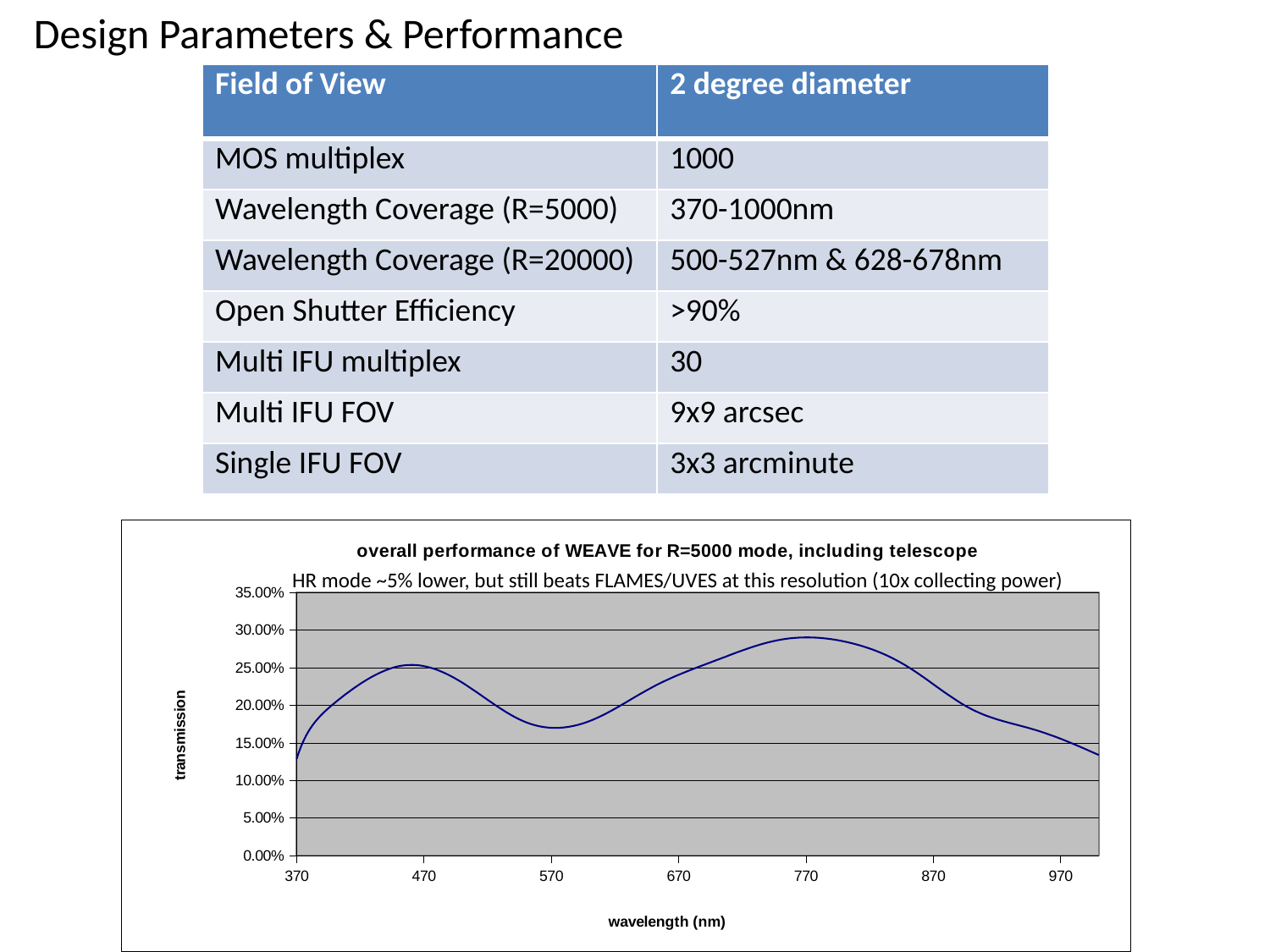
Which wavelength has the higher transmission, 770 nm or 570 nm? 770 nm Is the transmission at a wavelength of 470 nm greater or less than 20.00%? greater Does the transmission rise or fall as the wavelength increases from 570 nm to 770 nm? rise Is the transmission at a wavelength of 770 nm greater or less than 25.00%? greater What kind of chart is shown at the bottom of the slide? line chart How many labelled tick marks are shown on the wavelength axis of the chart? 7 Is the transmission at a wavelength of 970 nm greater or less than 20.00%? less What is the label of the vertical axis of the chart? transmission What is the title of the chart on the slide? overall performance of WEAVE for R=5000 mode, including telescope Does the transmission rise or fall as the wavelength increases from 770 nm to 970 nm? fall